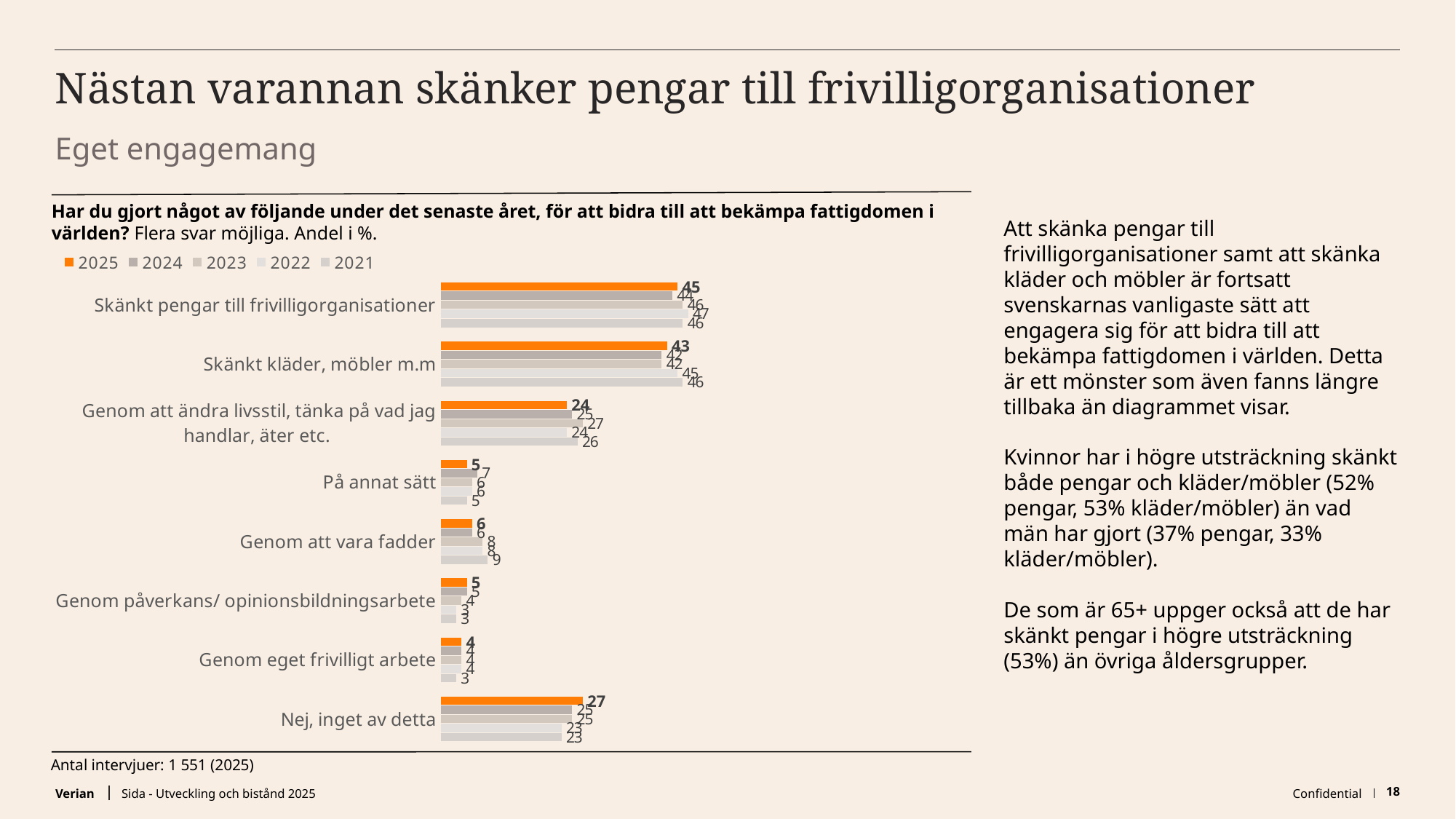
What is the difference between the 2025 values for "Skänkt pengar till frivilligorganisationer" and "Skänkt kläder, möbler m.m"? 2 What kind of chart is shown on the slide? Bar chart What is the 2025 value for "Skänkt pengar till frivilligorganisationer"? 45 How many series does the legend list? 5 What is the 2025 value for "Genom att ändra livsstil, tänka på vad jag handlar, äter etc."? 24 Which is larger in 2025: "Genom att vara fadder" or "Genom eget frivilligt arbete"? Genom att vara fadder How many categories are shown in the chart? 8 Which category has the highest 2025 value? Skänkt pengar till frivilligorganisationer What is the 2025 value for "Skänkt kläder, möbler m.m"? 43 Which series is shown in orange in the chart? 2025 What is the 2025 value for "Nej, inget av detta"? 27 Which category has the lowest 2025 value? Genom eget frivilligt arbete